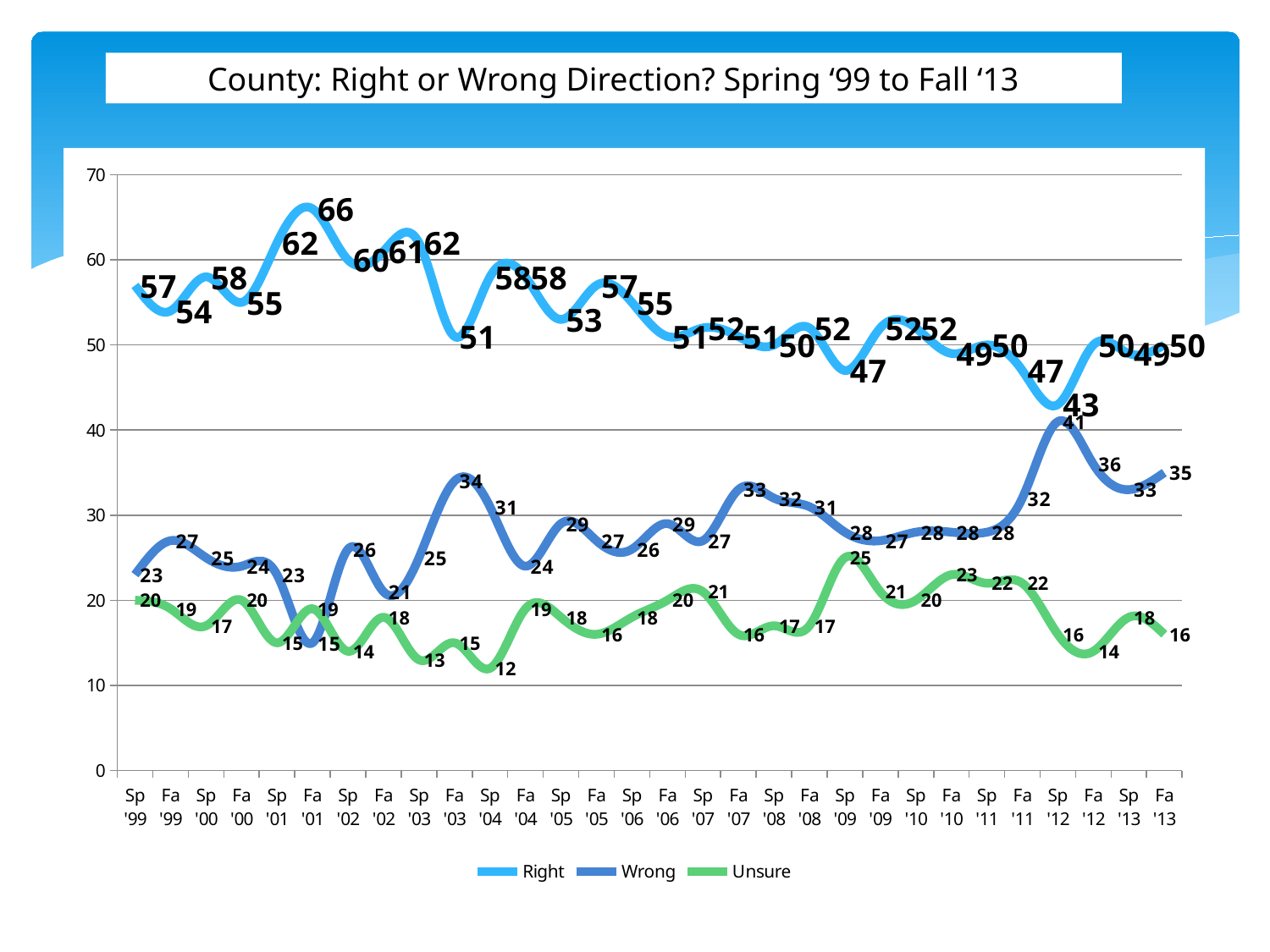
What is the value of the Wrong series in Sp '12? 41 In which period is the Unsure series at its lowest? Sp '04 What kind of chart is shown on the slide? line chart What is the difference between the Right and Wrong values in Fa '13? 15 What is the lowest value of the Right series? 43 What is the value of the Unsure series in Fa '10? 23 How many time periods are plotted along the x axis? 30 How many series does the legend list? 3 What is the highest value of the Unsure series? 25 Does the Right series generally rise or fall from Sp '99 to Fa '13? fall In which period does the Right series reach its highest value? Fa '01 Which is larger for the Wrong series: Fa '03 or Sp '04? Fa '03